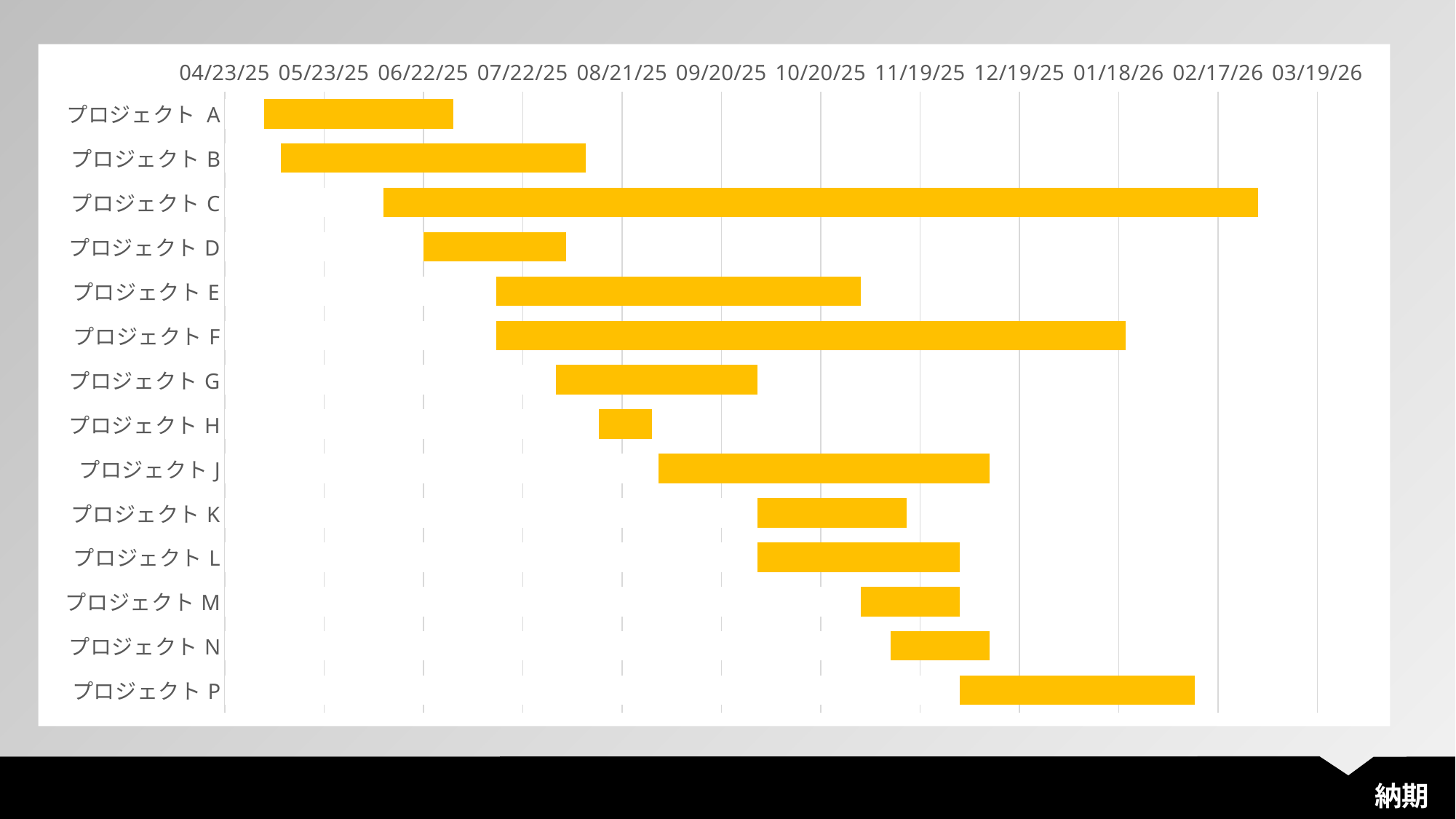
Which project has the longest bar in the chart? プロジェクト C Which project's bar starts latest on the timeline? プロジェクト P What colour are the bars in the chart? yellow How many projects are listed on the vertical axis of the chart? 14 Does the bar for プロジェクト C end before or after 02/17/26? after Which bar is longer, プロジェクト E or プロジェクト F? プロジェクト F Which project's bar starts earliest on the timeline? プロジェクト A Which project's bar ends latest on the timeline? プロジェクト C Does the bar for プロジェクト P start before or after 11/19/25? after Which bar is longer, プロジェクト B or プロジェクト D? プロジェクト B What kind of chart is shown on the slide? bar chart Which project has the shortest bar in the chart? プロジェクト H